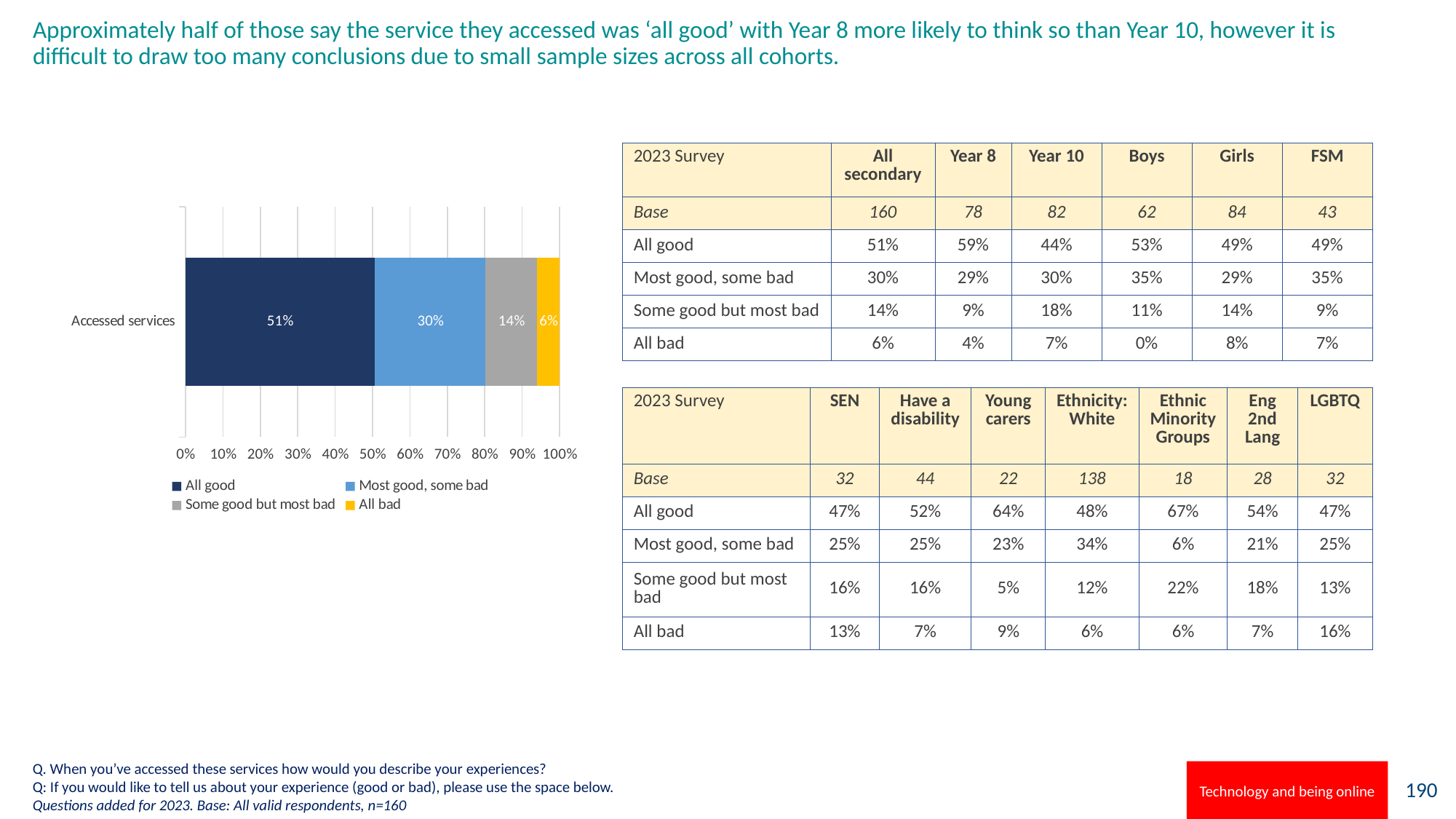
What is the difference between the 'All good' and 'Most good, some bad' segments? 21% Which is larger in the chart: 'Some good but most bad' or 'All bad'? Some good but most bad What is the value for 'All good' in the Accessed services bar? 51% What is the value for 'Some good but most bad' in the Accessed services bar? 14% Which series has the largest segment in the Accessed services bar? All good Which series has the smallest segment in the Accessed services bar? All bad How many series does the chart legend list? 4 What colour is the 'All bad' segment in the chart? Yellow What is the value for 'Most good, some bad' in the Accessed services bar? 30% How many categories are plotted on the chart's vertical axis? 1 What type of chart is shown on the slide? Stacked bar chart What is the value for 'All bad' in the Accessed services bar? 6%